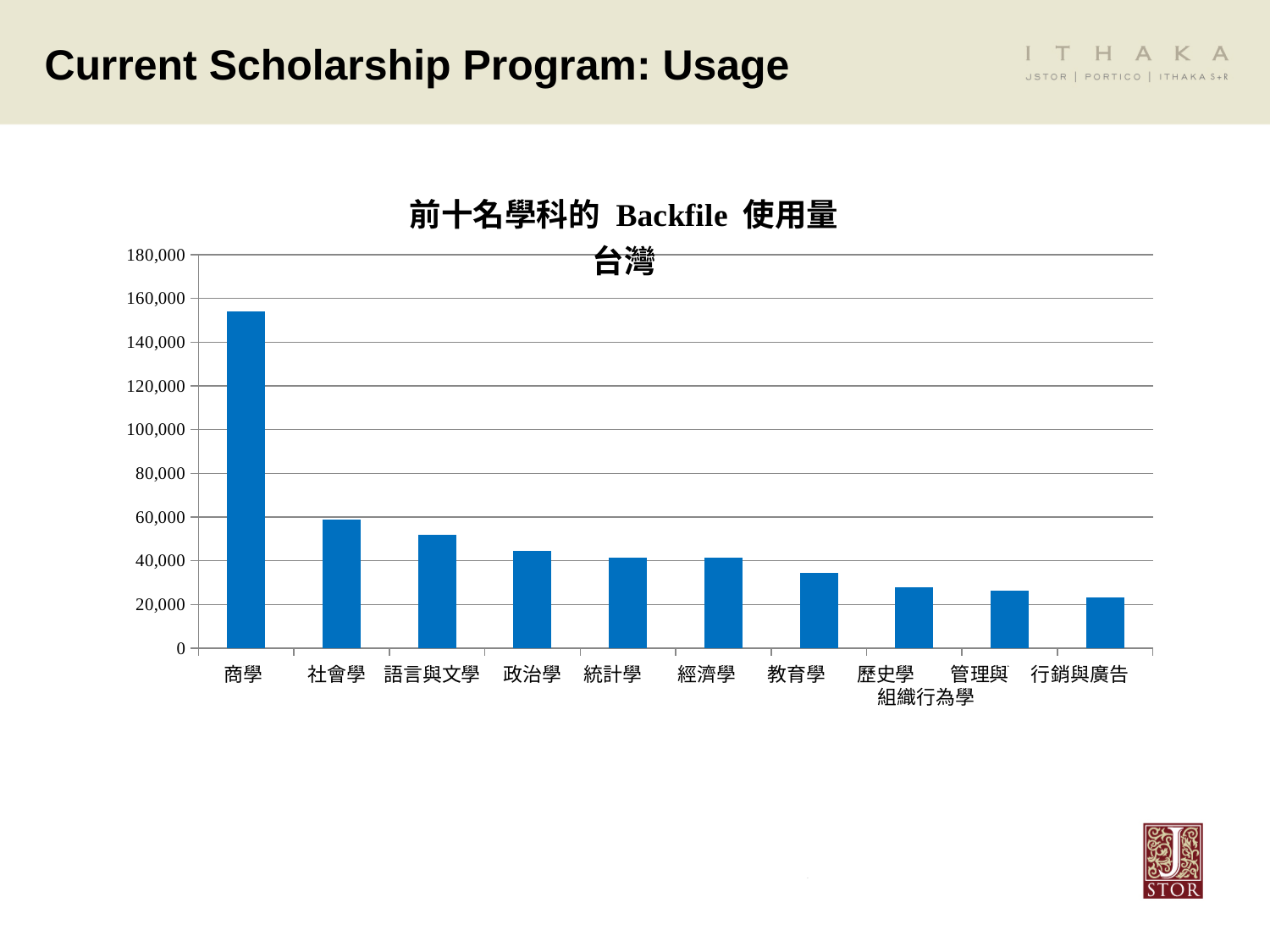
Is the value for 行銷與廣告 greater or less than 20,000? greater Is the value for 教育學 greater or less than 40,000? less Is the value for 商學 greater or less than 140,000? greater What is the title of the chart? 前十名學科的 Backfile 使用量 台灣 Which subject has the highest Backfile usage? 商學 Which subject has the lowest Backfile usage? 行銷與廣告 Which has the larger value, 社會學 or 政治學? 社會學 Do the values generally rise or fall moving from left to right along the x axis? fall What kind of chart is shown on the slide? bar chart How many subject categories are plotted on the chart? 10